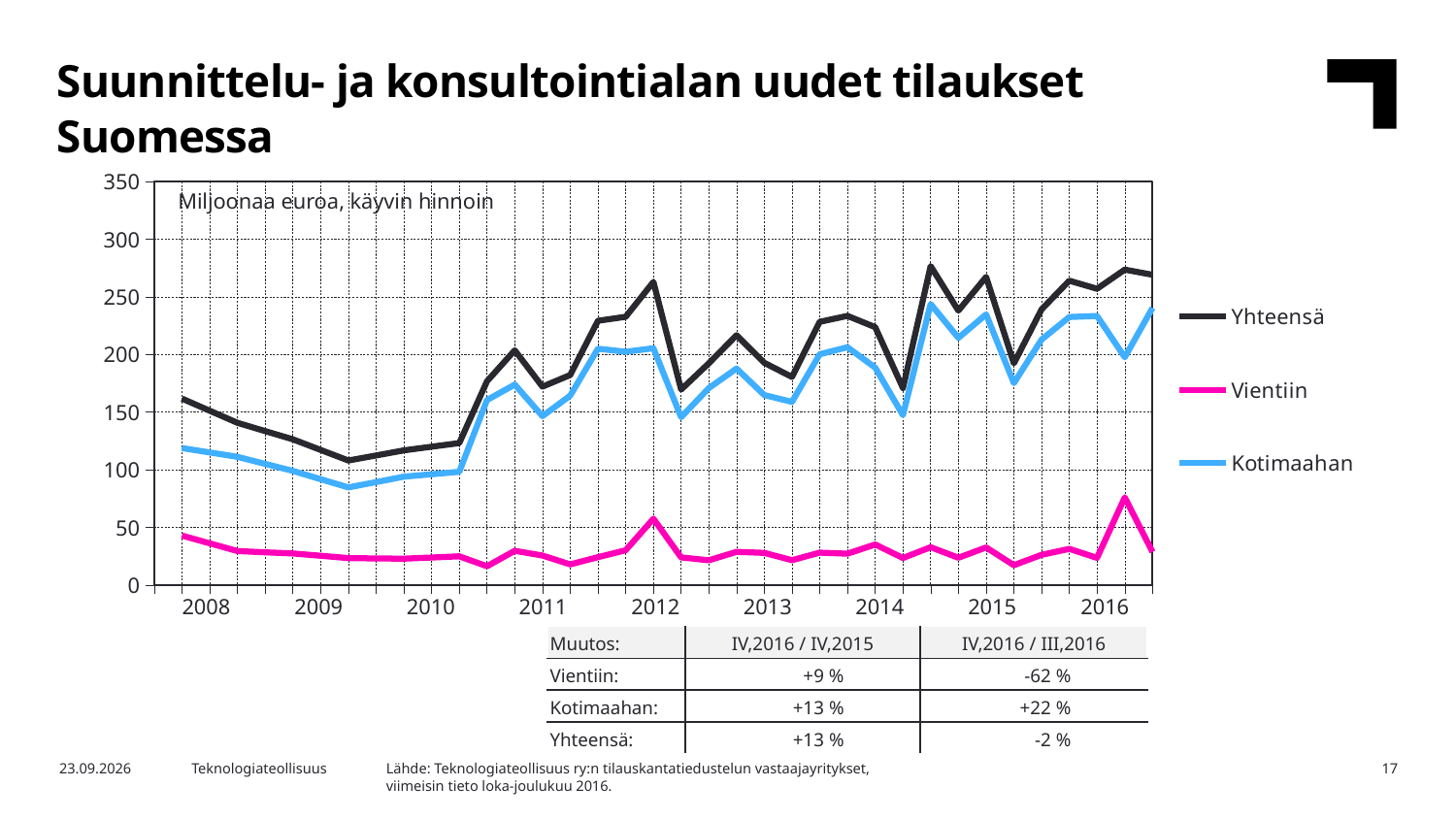
Is the value of Yhteensä at the start of 2008 greater or less than 150? greater What unit is stated inside the chart area? Miljoonaa euroa, käyvin hinnoin Which series has the highest values throughout the chart? Yhteensä Is the highest value of the Yhteensä series greater or less than 250? greater What kind of chart is shown on the slide? Line chart How many years are labelled on the x axis? 9 Is the Vientiin series ever greater or less than 100 over the whole period? less Which series are listed in the chart legend? Yhteensä, Vientiin, Kotimaahan Which series is larger at the end of 2016, Kotimaahan or Vientiin? Kotimaahan How many series does the chart legend list? 3 Which series has the lowest values throughout the chart? Vientiin